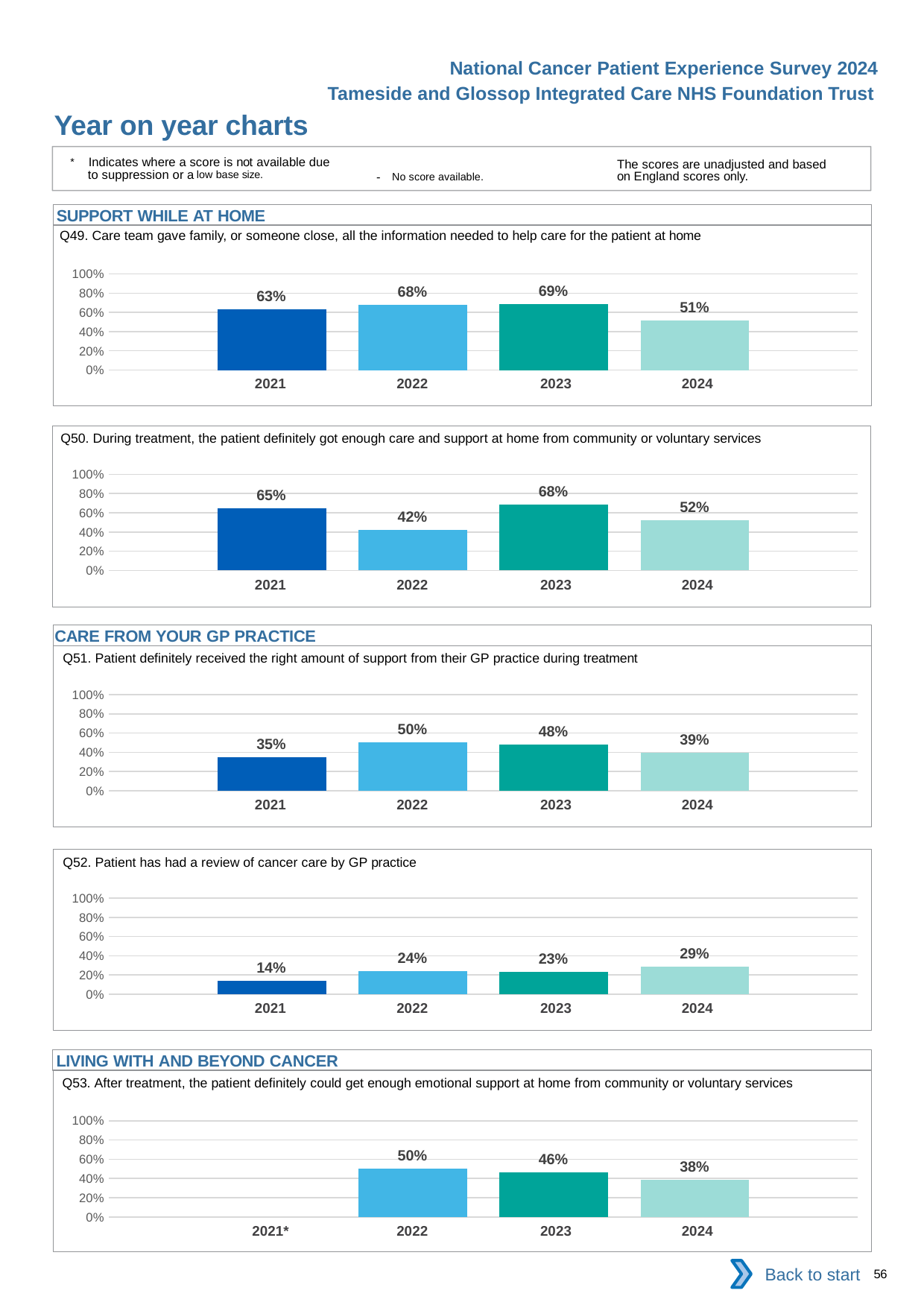
In the Q53 chart, do the values rise or fall from 2022 to 2024? fall In the Q51 chart, which is larger, the value for 2022 or the value for 2024? 2022 In the Q50 chart, what is the difference between the 2023 and 2022 values? 26% In the Q53 chart, what is the value for 2022? 50% In the Q53 chart, which year has no bar shown? 2021* What type of chart is used for Q49? bar chart In the Q49 chart, which year has the lowest value? 2024 In the Q50 chart, which year has the highest value? 2023 In the Q52 chart, how many years are plotted with bars? 4 In the Q49 chart, what is the value for 2023? 69% In the Q52 chart, what is the value for 2024? 29% In the Q51 chart, what is the value for 2021? 35%